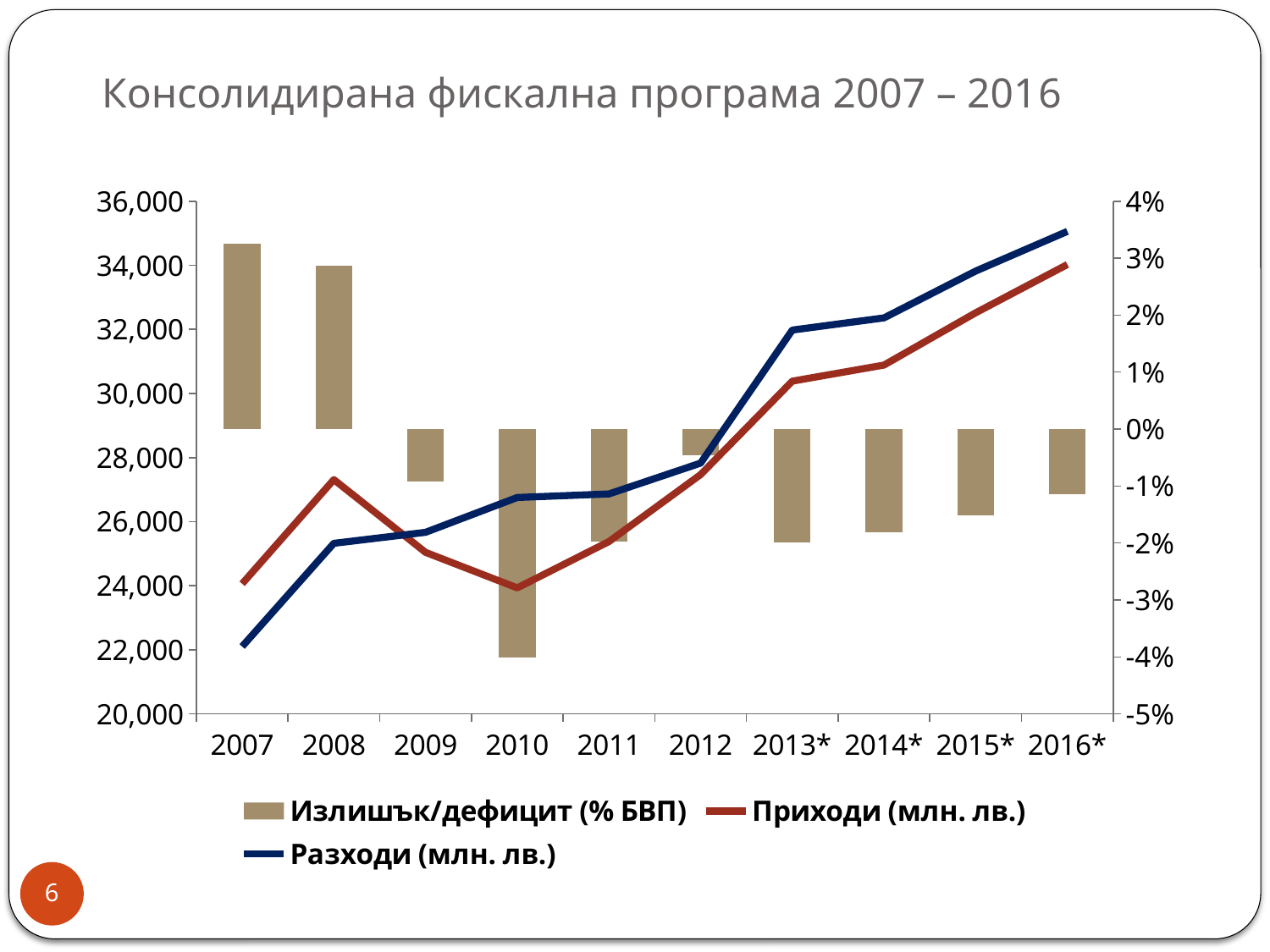
In which year is the bar for Излишък/дефицит (% БВП) the lowest? 2010 In which year is the bar for Излишък/дефицит (% БВП) the highest? 2007 Is the value of Разходи (млн. лв.) for 2007 greater or less than 24,000? less In 2016*, which is larger: Приходи (млн. лв.) or Разходи (млн. лв.)? Разходи (млн. лв.) Is the value of Излишък/дефицит (% БВП) for 2007 greater or less than 2%? greater What is the title of the chart on the slide? Консолидирана фискална програма 2007 – 2016 What kind of chart is shown on the slide? Combined bar and line chart How many years are shown on the x axis of the chart? 10 Is the value of Излишък/дефицит (% БВП) for 2010 greater or less than -3%? less How many series does the chart legend list? 3 Does the Разходи (млн. лв.) line generally rise or fall from 2007 to 2016*? rise